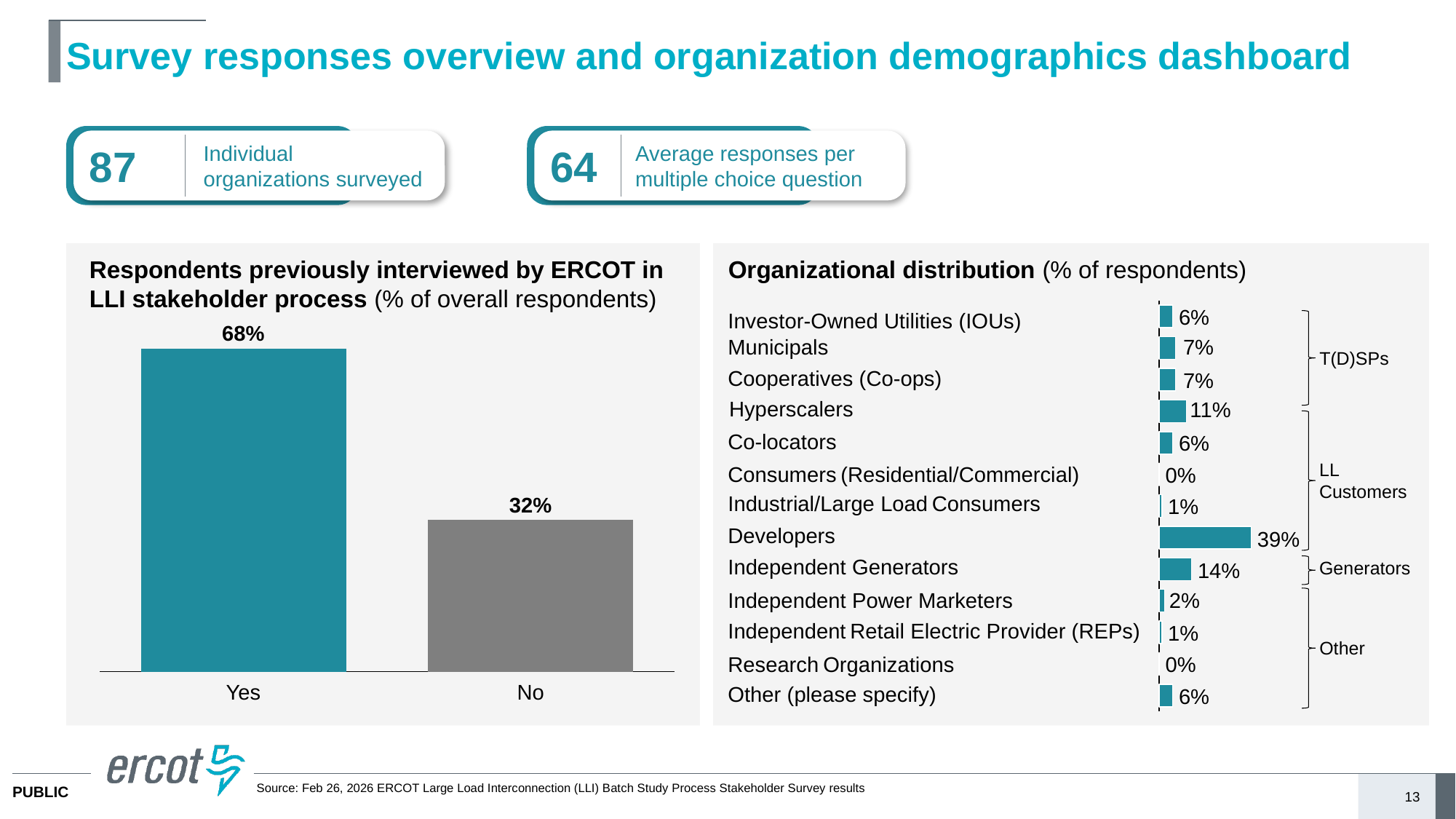
In the 'Respondents previously interviewed by ERCOT in LLI stakeholder process' chart, what is the value for Yes? 68% What kind of chart is the 'Respondents previously interviewed by ERCOT in LLI stakeholder process' chart? bar chart In the 'Respondents previously interviewed by ERCOT in LLI stakeholder process' chart, what is the difference between the Yes and No values? 36% In the 'Organizational distribution' chart, what is the value for Independent Generators? 14% In the 'Respondents previously interviewed by ERCOT in LLI stakeholder process' chart, what is the value for No? 32% In the 'Organizational distribution' chart, how many categories are shown? 13 In the 'Organizational distribution' chart, which category has the highest value? Developers In the 'Organizational distribution' chart, what is the difference between Developers and Independent Generators? 25% In the 'Organizational distribution' chart, what is the value for Hyperscalers? 11% In the 'Organizational distribution' chart, which is larger, Hyperscalers or Co-locators? Hyperscalers In the 'Organizational distribution' chart, what is the value for Developers? 39% In the 'Organizational distribution' chart, what is the value for Independent Power Marketers? 2%